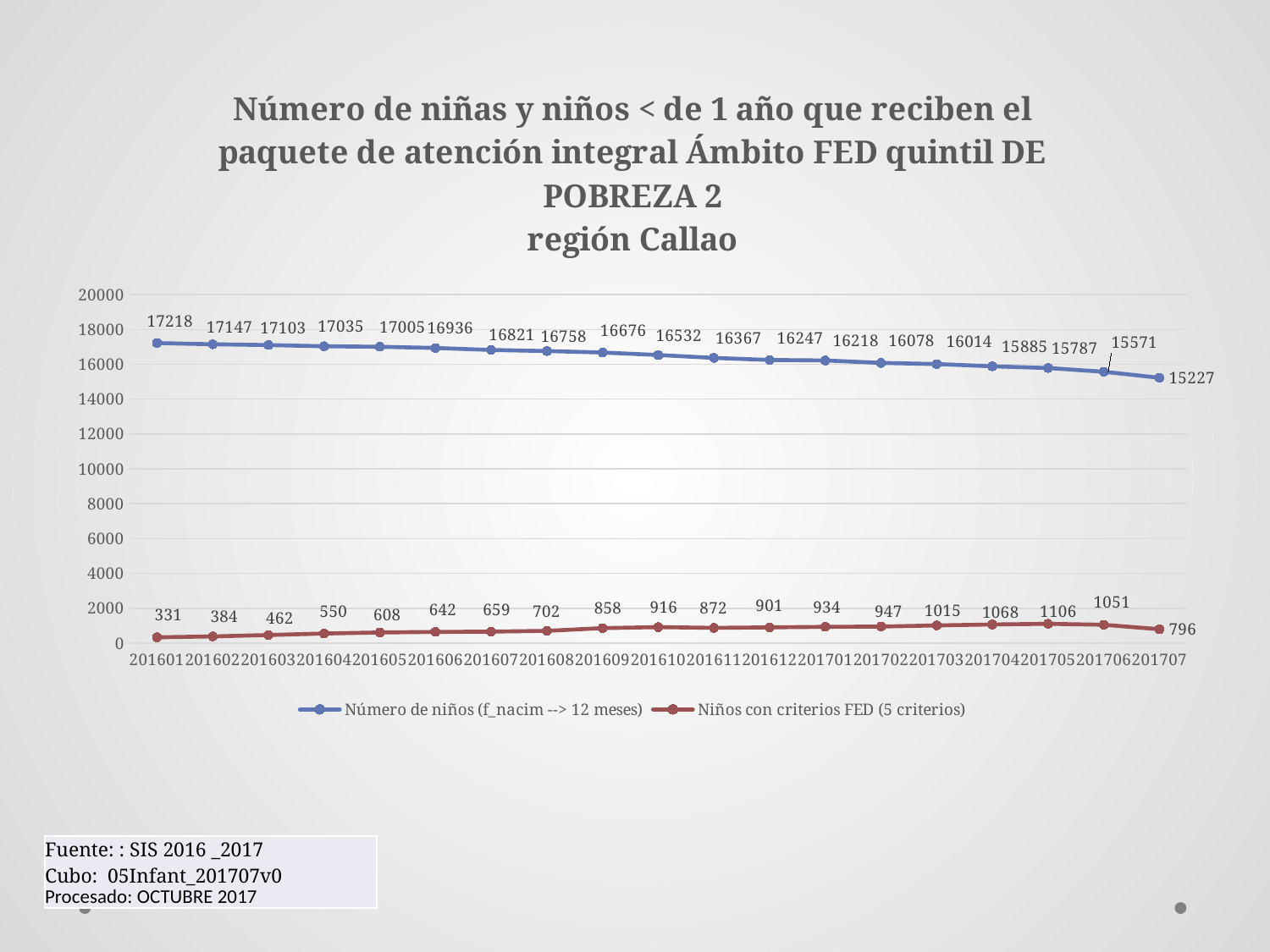
Does the 'Número de niños (f_nacim --> 12 meses)' series rise or fall from 201601 to 201707? Fall In which period is 'Niños con criterios FED (5 criterios)' lowest? 201601 Which region is named in the chart title? Callao In which period is 'Niños con criterios FED (5 criterios)' highest? 201705 What type of chart is shown on the slide? Line chart What is the difference between the 'Número de niños (f_nacim --> 12 meses)' values for 201601 and 201707? 1991 What is the value of 'Número de niños (f_nacim --> 12 meses)' for 201601? 17218 Which is larger, the 'Niños con criterios FED (5 criterios)' value for 201610 or for 201611? 201610 How many time points are plotted along the x axis? 19 What is the value of 'Número de niños (f_nacim --> 12 meses)' for 201707? 15227 What is the value of 'Niños con criterios FED (5 criterios)' for 201705? 1106 How many series does the legend list? 2